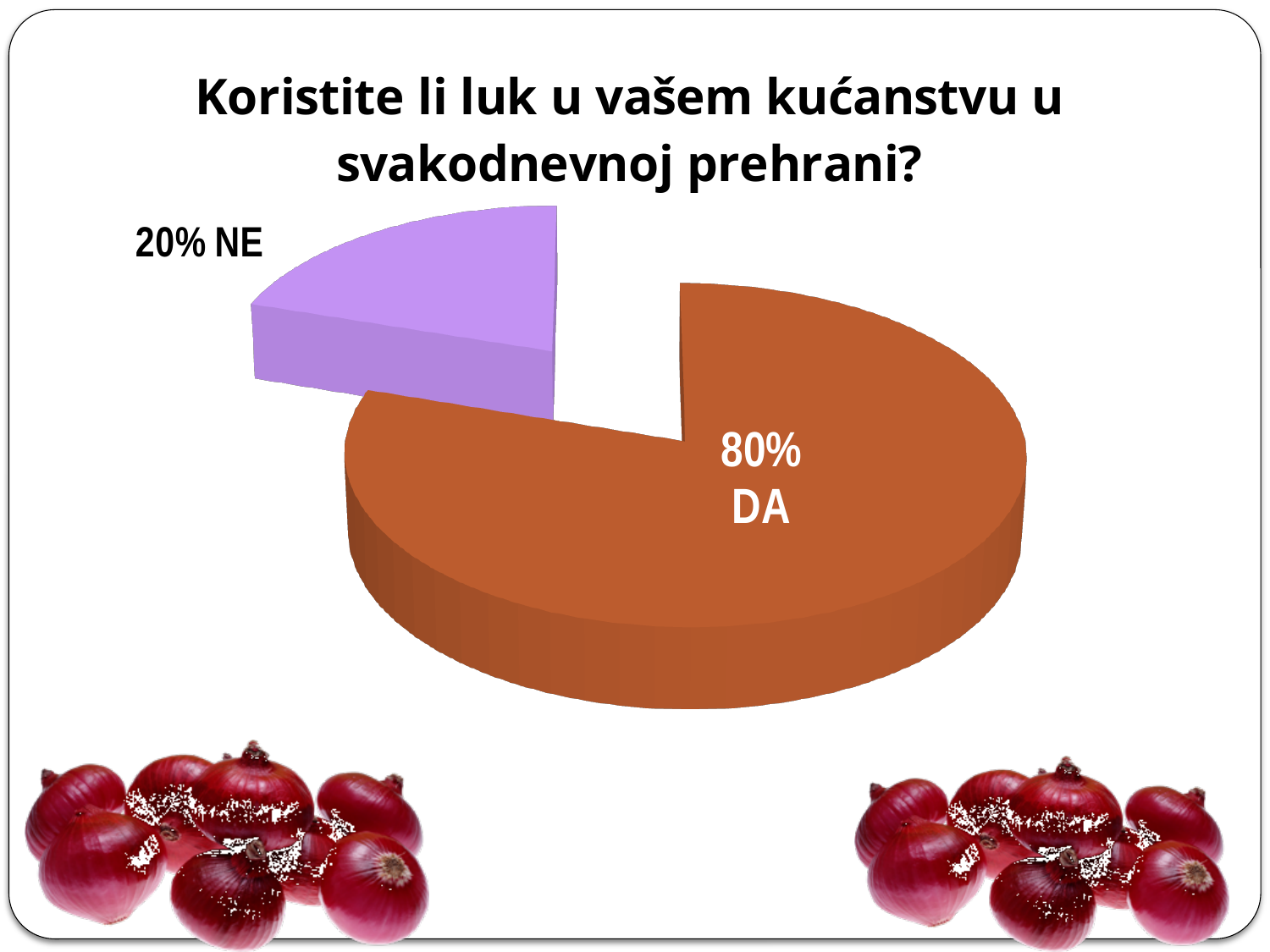
What colour is the DA slice? brown/orange What is the difference in percentage points between the DA and NE slices? 60 What share of the pie does the NE slice represent? 20% What kind of chart is shown on the slide? pie chart Which slice is the smallest? NE Which is larger, the DA slice or the NE slice? DA What is the title of the chart? Koristite li luk u vašem kućanstvu u svakodnevnoj prehrani? Is the share for NE greater or less than 50%? less Which slice is the largest? DA What share of the pie does the DA slice represent? 80% What is the total of the two slices' percentages? 100% How many slices does the pie chart have? 2